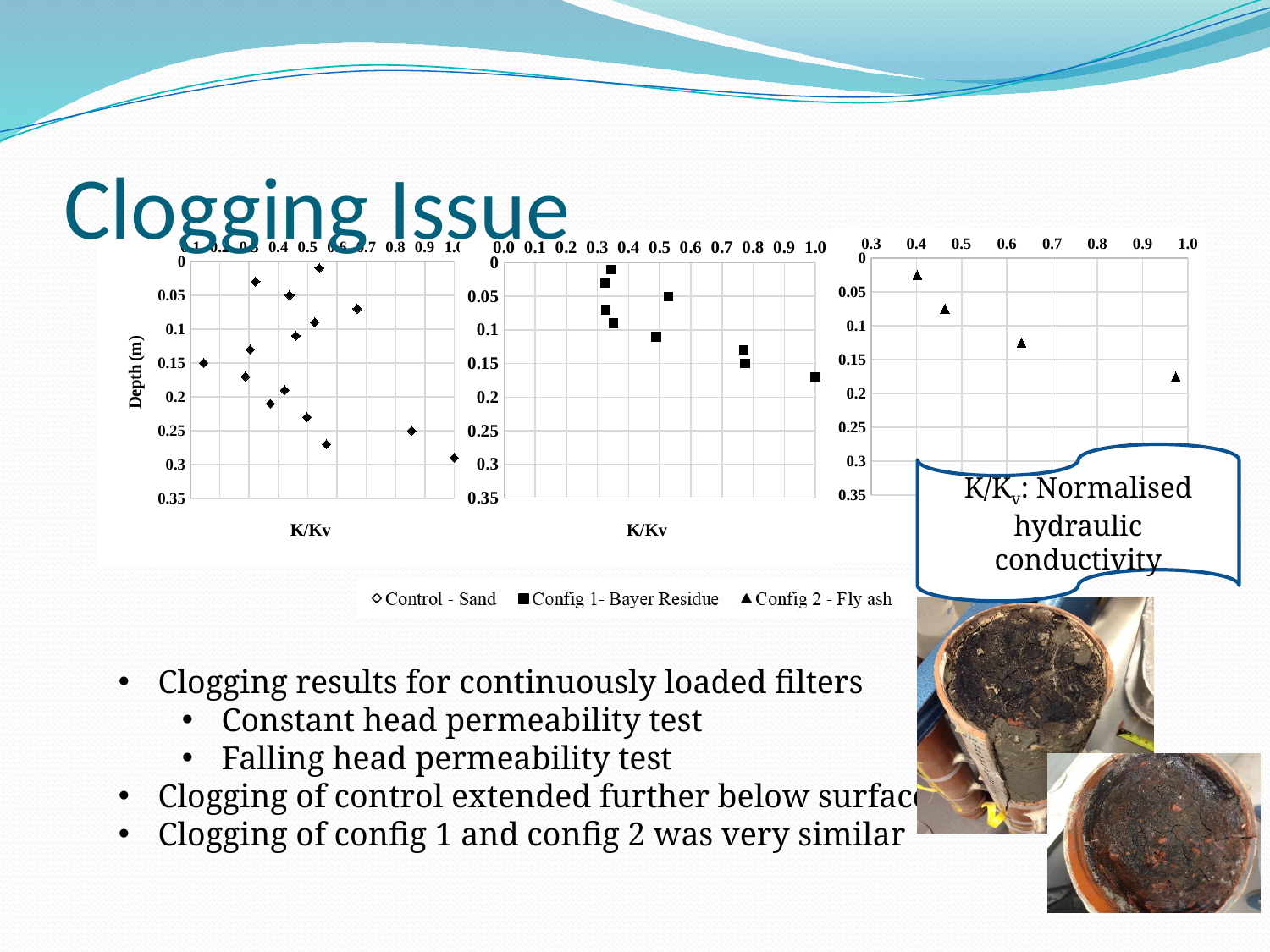
What kind of chart is the left-hand chart (Control - Sand)? Scatter chart In the left-hand chart (Control - Sand), which point is deepest: the one at K/Kv of 1.0 or the one at K/Kv of about 0.85? The one at K/Kv of 1.0 What is the maximum value shown on the depth axis of the charts? 0.35 In the left-hand chart (Control - Sand), is the depth of the point at K/Kv of 1.0 greater or less than 0.25? greater In the right-hand chart (Config 2 - Fly ash), does depth increase or decrease as K/Kv increases? increase How many series does the legend below the charts list? 3 What is the label on the vertical axis of the left-hand chart? Depth (m) How many data points are plotted in the right-hand chart (Config 2 - Fly ash)? 4 In the middle chart (Config 1 - Bayer Residue), is the depth of the point at K/Kv of 1.0 greater or less than 0.2? less Which of the three charts has points extending to the greatest depth? Control - Sand (left chart) What are the three series named in the legend? Control - Sand, Config 1- Bayer Residue, Config 2 - Fly ash In the right-hand chart (Config 2 - Fly ash), is the depth of the point at K/Kv of about 1.0 greater or less than 0.2? less